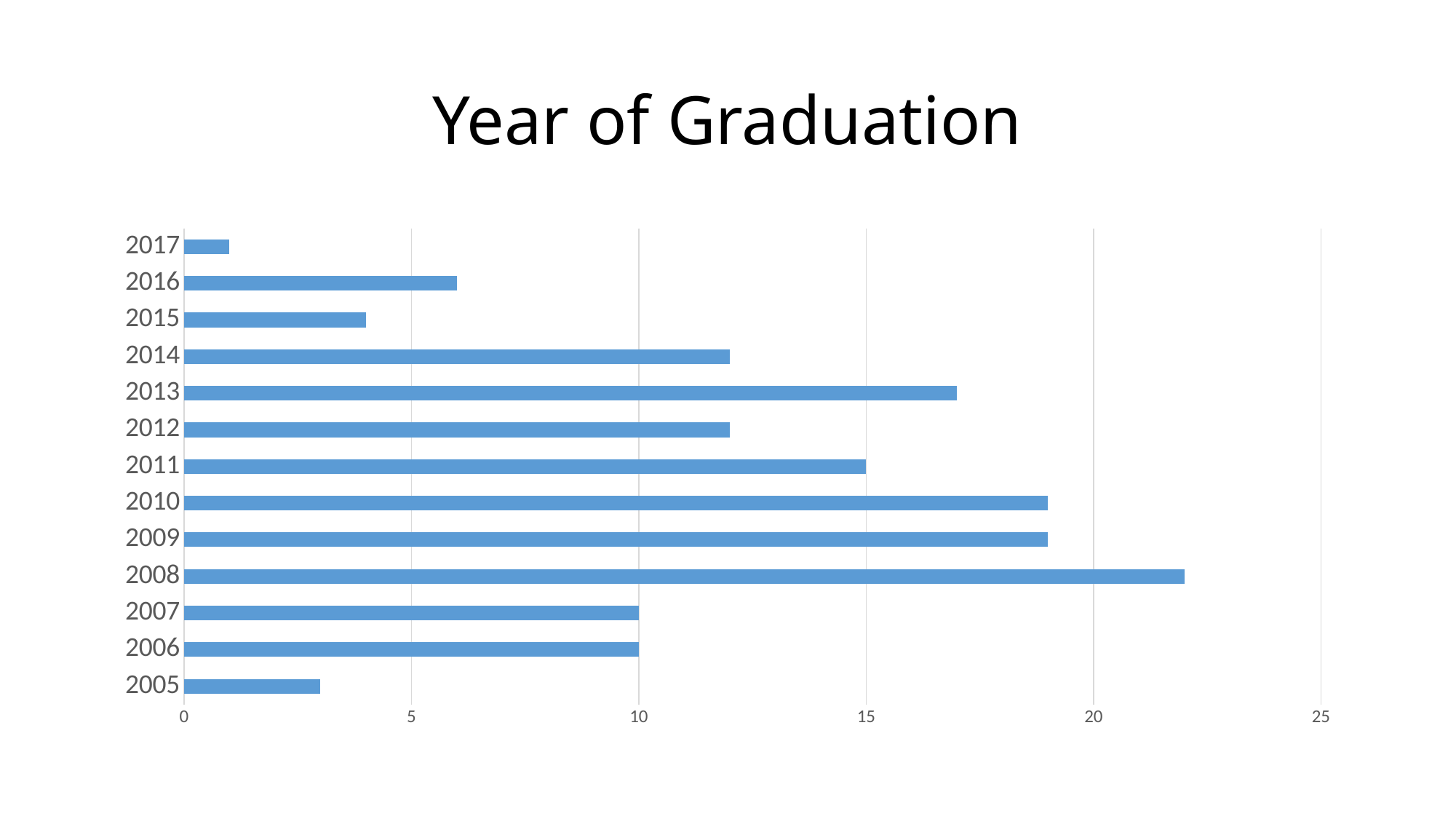
Which year has the lowest value? 2017 What is the value for 2011? 15 Is the value for 2013 greater or less than 15? greater What kind of chart is shown on the slide? bar chart Which is larger, the value for 2014 or the value for 2016? 2014 What is the value for 2007? 10 Which year has the highest value? 2008 Which is larger, the value for 2005 or the value for 2010? 2010 How many years are shown on the chart? 13 What is the title of the chart? Year of Graduation Is the value for 2008 greater or less than 20? greater Is the value for 2015 greater or less than 5? less